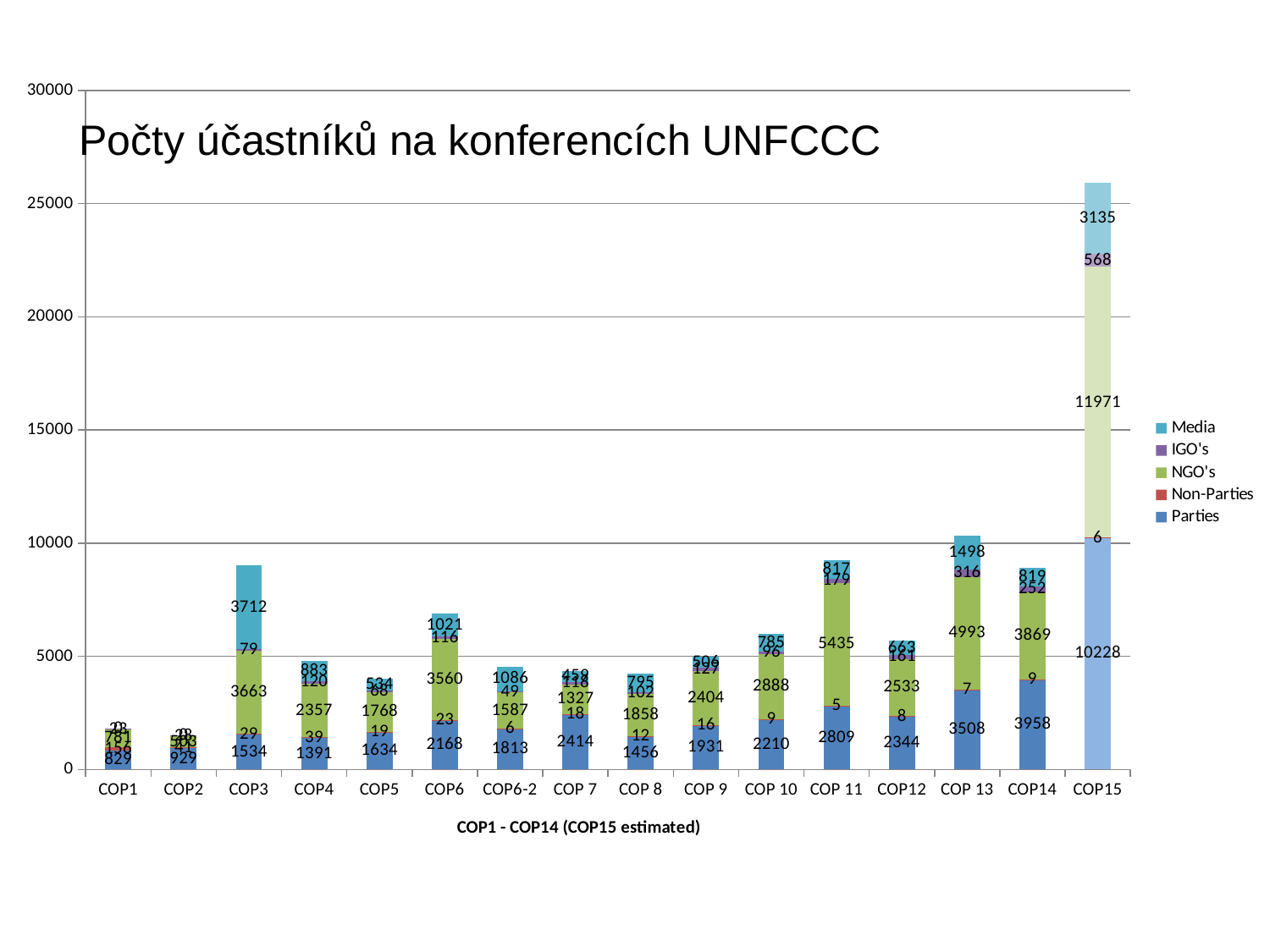
What is the NGO's value for COP 11? 5435 What is the difference between the Parties value for COP14 and for COP 13? 450 How many series does the legend list? 5 What is the Parties value for COP15? 10228 What is the total number of participants for COP15? 25908 What is the Media value for COP3? 3712 What is the x-axis label of the chart? COP1 - COP14 (COP15 estimated) What is the IGO's value for COP 13? 316 How many conferences (categories) are shown on the x axis? 16 Which is larger, the NGO's value for COP 11 or for COP 13? COP 11 What kind of chart is shown on the slide? Stacked bar chart Which conference has the highest total number of participants? COP15